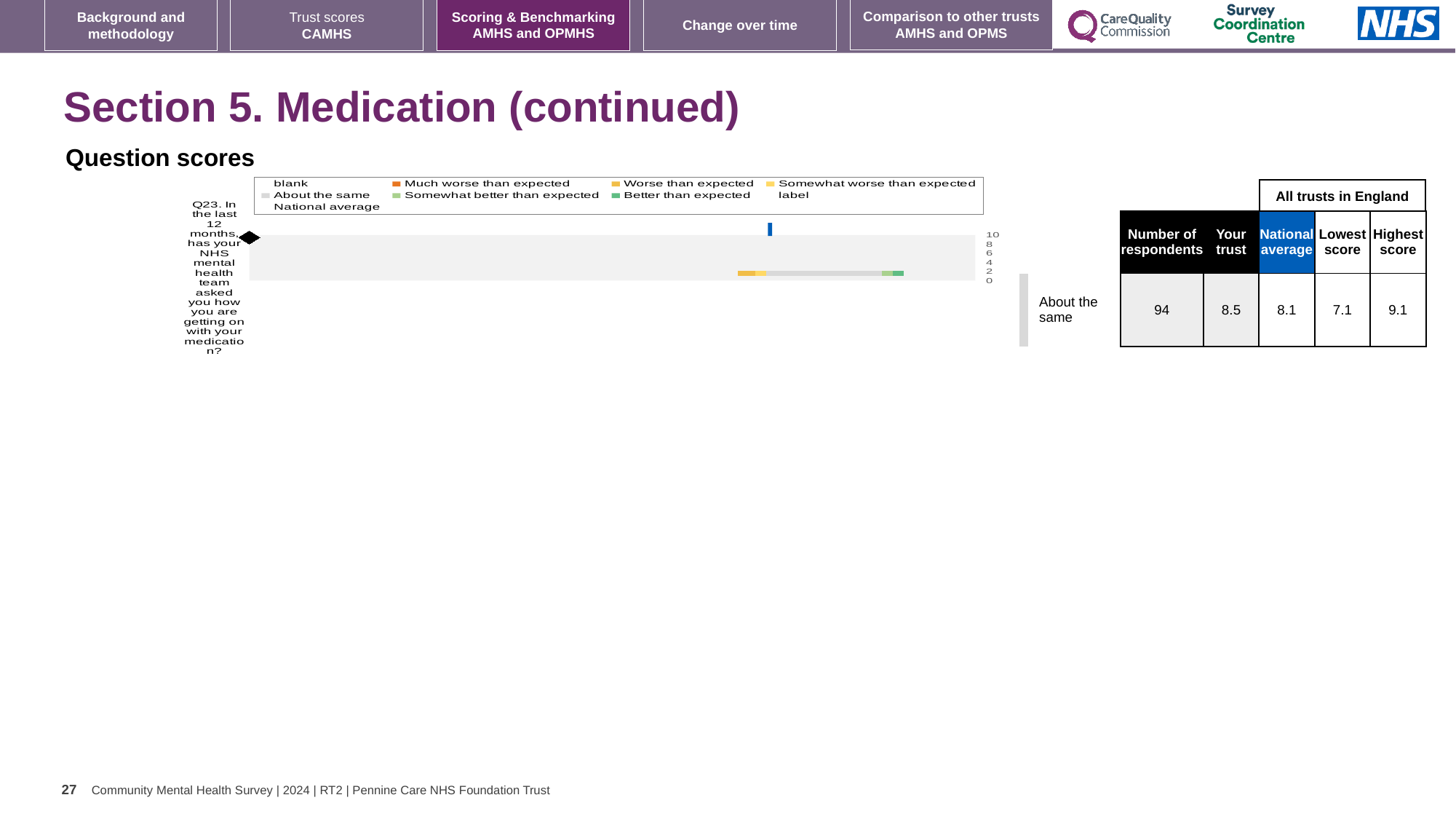
Which question is plotted on the chart? Q23. In the last 12 months, has your NHS mental health team asked you how you are getting on with your medication? How many question categories are plotted on the chart? 1 What kind of chart is shown under 'Question scores'? bar chart What is the highest tick value shown on the chart's value axis? 10 Which is larger for Q23, the 'Your trust' score or the national average? Your trust According to the table next to the chart, what is the national average for Q23? 8.1 Which legend entry is shown in dark green? Better than expected According to the table next to the chart, how many respondents answered Q23? 94 How many entries does the chart legend list? 9 According to the table next to the chart, what is the 'Your trust' score for Q23? 8.5 According to the table next to the chart, what is the lowest score among all trusts in England for Q23? 7.1 According to the table next to the chart, what is the highest score among all trusts in England for Q23? 9.1